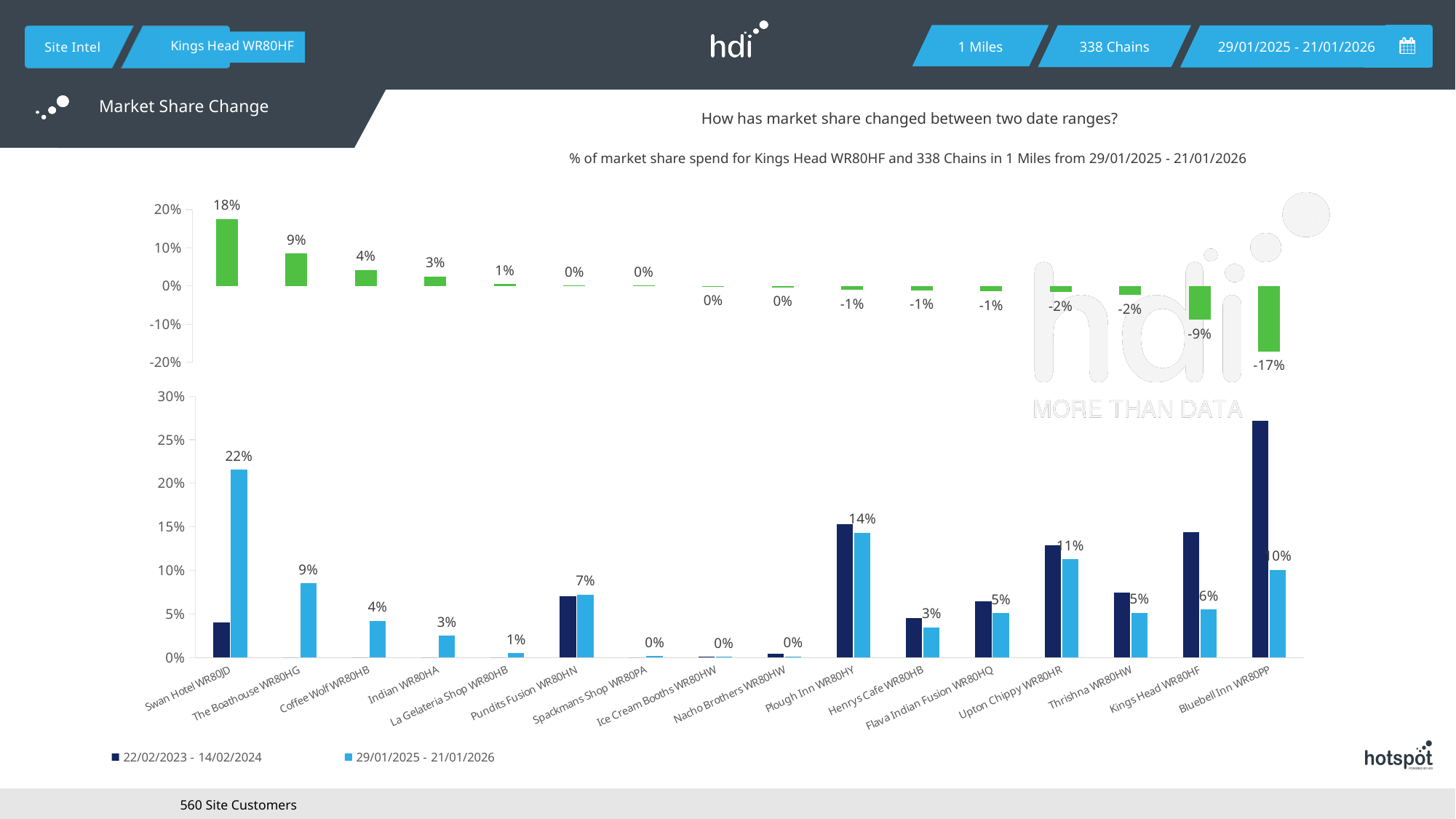
In the top chart (market share change), what is the value for Kings Head WR80HF? -9% In the bottom chart, how many categories are shown on the x axis? 16 In the bottom chart, what is the difference between the 29/01/2025 - 21/01/2026 values for Swan Hotel WR80JD and The Boathouse WR80HG? 13% What kind of chart is the bottom chart? Bar chart In the bottom chart, is the value for Bluebell Inn WR80PP in the 22/02/2023 - 14/02/2024 series greater or less than 25%? greater In the bottom chart, how many series does the legend list? 2 In the top chart (market share change), which category has the lowest value? Bluebell Inn WR80PP In the top chart (market share change), what is the value for Swan Hotel WR80JD? 18% In the top chart (market share change), which category has the highest value? Swan Hotel WR80JD In the top chart (market share change), what is the value for Bluebell Inn WR80PP? -17% In the bottom chart, what is the labelled value for Upton Chippy WR80HR in the 29/01/2025 - 21/01/2026 series? 11% In the bottom chart, what is the labelled value for Plough Inn WR80HY in the 29/01/2025 - 21/01/2026 series? 14%